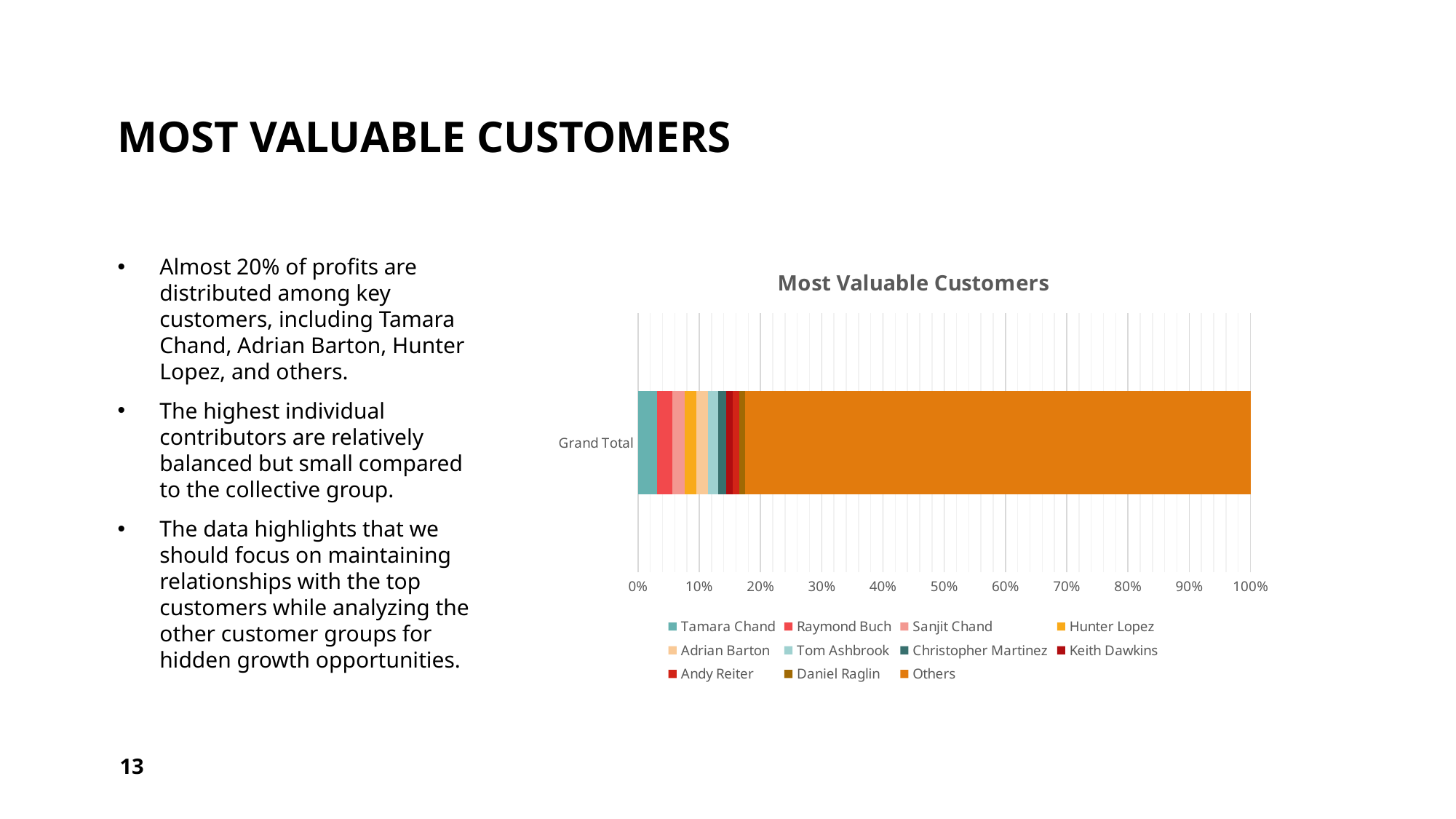
How many series does the chart legend list? 11 Is the value for Tamara Chand greater or less than 10%? less What is the highest value shown on the horizontal axis of the chart? 100% How many categories are plotted on the vertical axis of the chart? 1 Which is larger in the Grand Total bar, Tamara Chand or Daniel Raglin? Tamara Chand What kind of chart is shown on the slide? Stacked bar chart Which series takes up the largest share of the Grand Total bar? Others Is the value for Others greater or less than 70%? greater What is the title of the chart? Most Valuable Customers What is the label of the single category on the vertical axis? Grand Total Which is larger in the Grand Total bar, Others or Tamara Chand? Others Is the value for Raymond Buch greater or less than 10%? less